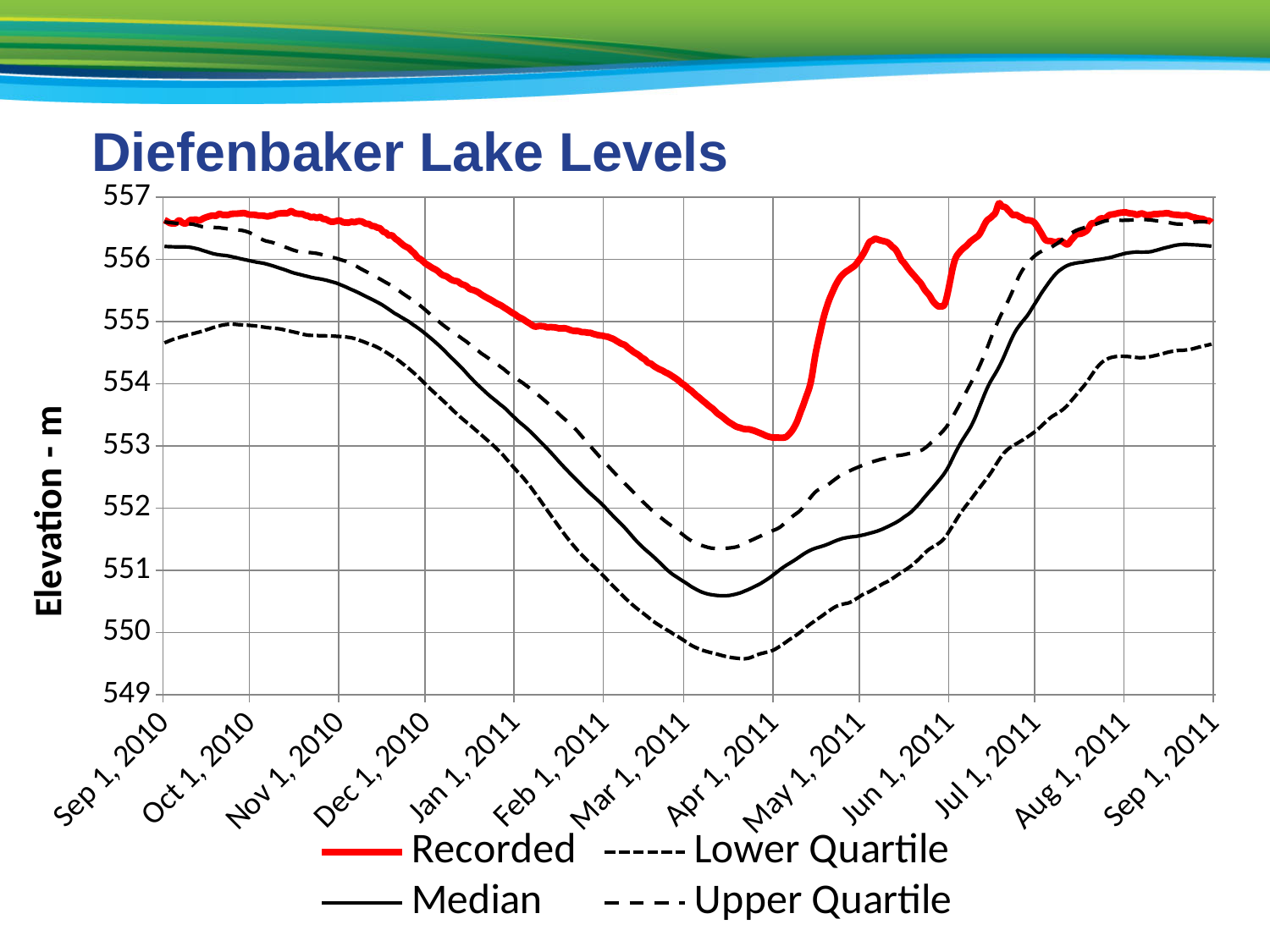
What kind of chart is shown on the slide? line chart How many series does the legend list? 4 What is the title of the chart? Diefenbaker Lake Levels Is the Lower Quartile value on Apr 1, 2011 greater or less than 550? less On Apr 1, 2011, which is larger, the Recorded value or the Median value? Recorded Is the Recorded value on Sep 1, 2010 greater or less than 556? greater How many date ticks are labelled on the x axis? 13 Which series is drawn in red? Recorded Does the Median series rise or fall from Sep 1, 2010 to Apr 1, 2011? fall Is the Recorded value on Apr 1, 2011 greater or less than 554? less